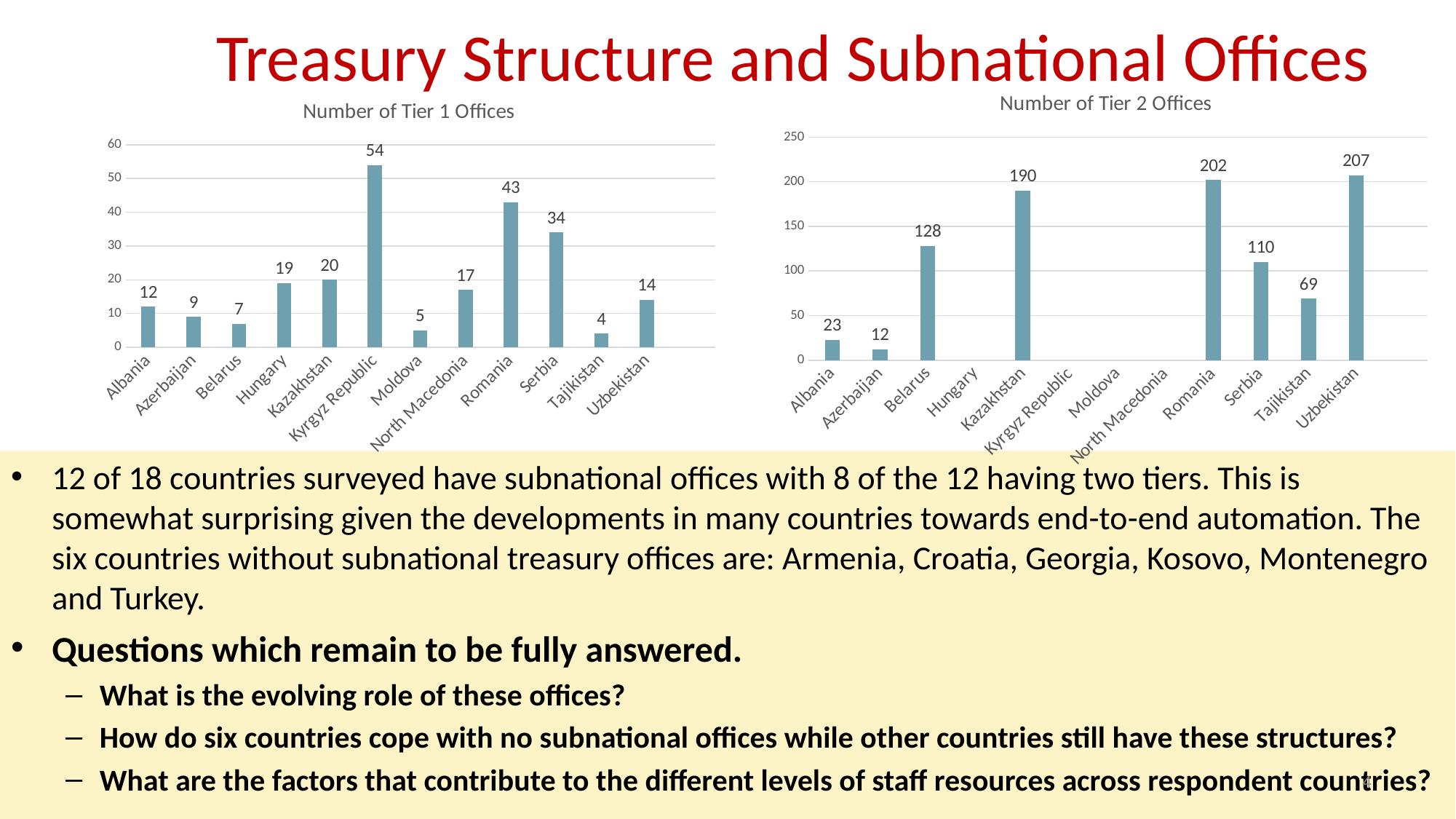
In the 'Number of Tier 2 Offices' chart, which country has the highest value? Uzbekistan In the 'Number of Tier 1 Offices' chart, what is the value for Kyrgyz Republic? 54 In the 'Number of Tier 2 Offices' chart, what is the value for Kazakhstan? 190 What is the title of the chart on the left side of the slide? Number of Tier 1 Offices In the 'Number of Tier 1 Offices' chart, what is the difference between Romania and Serbia? 9 In the 'Number of Tier 2 Offices' chart, what is the value for Tajikistan? 69 In the 'Number of Tier 1 Offices' chart, which country has the lowest value? Tajikistan In the 'Number of Tier 2 Offices' chart, what is the difference between Uzbekistan and Romania? 5 In the 'Number of Tier 1 Offices' chart, how many countries are shown on the x axis? 12 In the 'Number of Tier 2 Offices' chart, which is larger, Belarus or Serbia? Belarus In the 'Number of Tier 1 Offices' chart, which is larger, Hungary or Kazakhstan? Kazakhstan What type of chart is the 'Number of Tier 2 Offices' chart? Bar chart